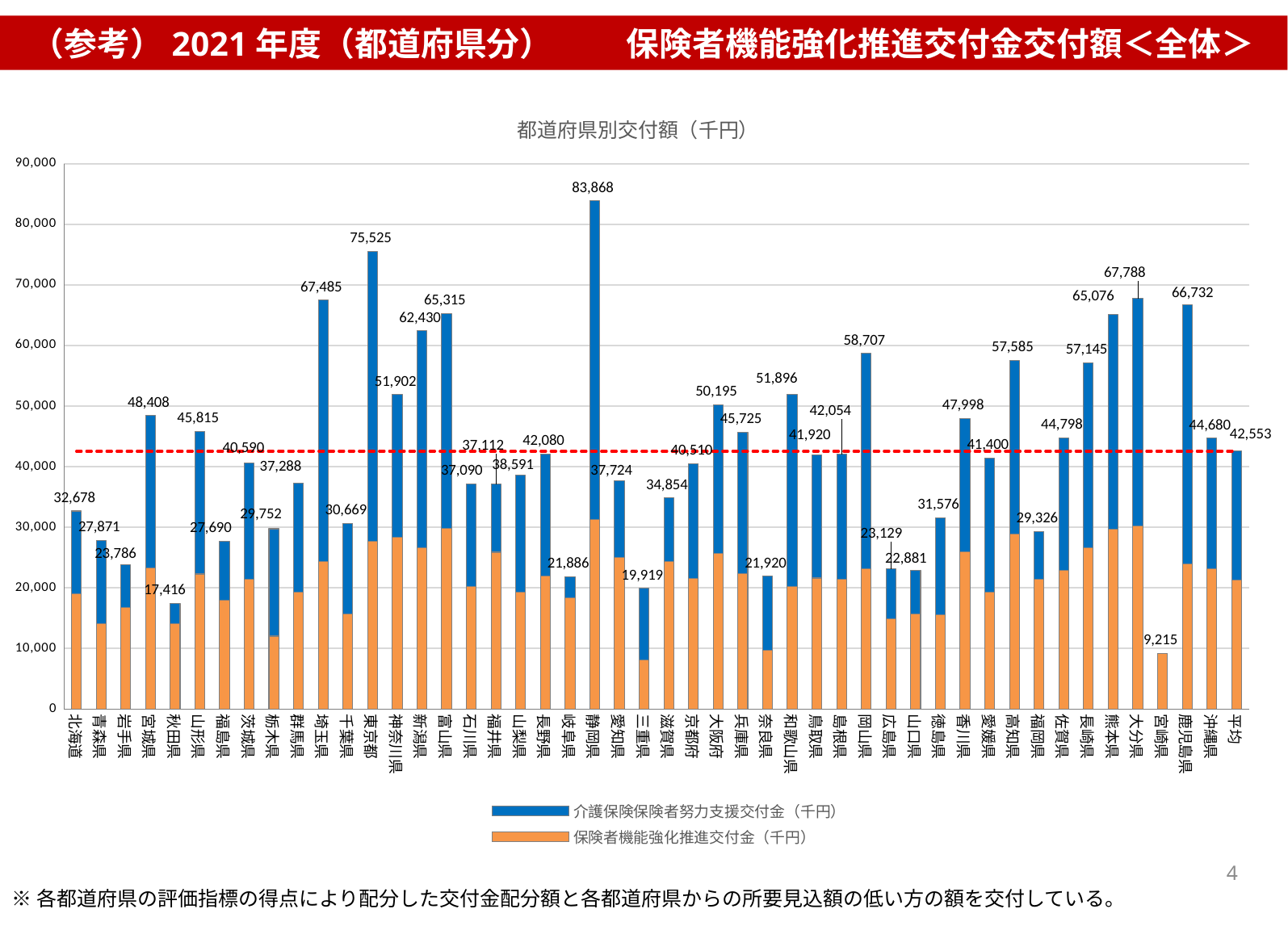
How many categories are plotted along the x axis (including 平均)? 48 Is the value of the 保険者機能強化推進交付金 (orange) segment for 三重県 greater or less than 10,000? less Which prefecture has the lowest total value? 宮崎県 What is the title of the chart? 都道府県別交付額（千円） What is the difference between the total values for 静岡県 and 東京都? 8,343 How many series does the legend list? 2 What type of chart is shown on the slide? Stacked bar chart Which has a larger total value, 埼玉県 or 千葉県? 埼玉県 Which prefecture has the highest total value? 静岡県 What is the total value labeled for 宮崎県? 9,215 What is the total value labeled for 静岡県? 83,868 What is the total value labeled for 平均? 42,553